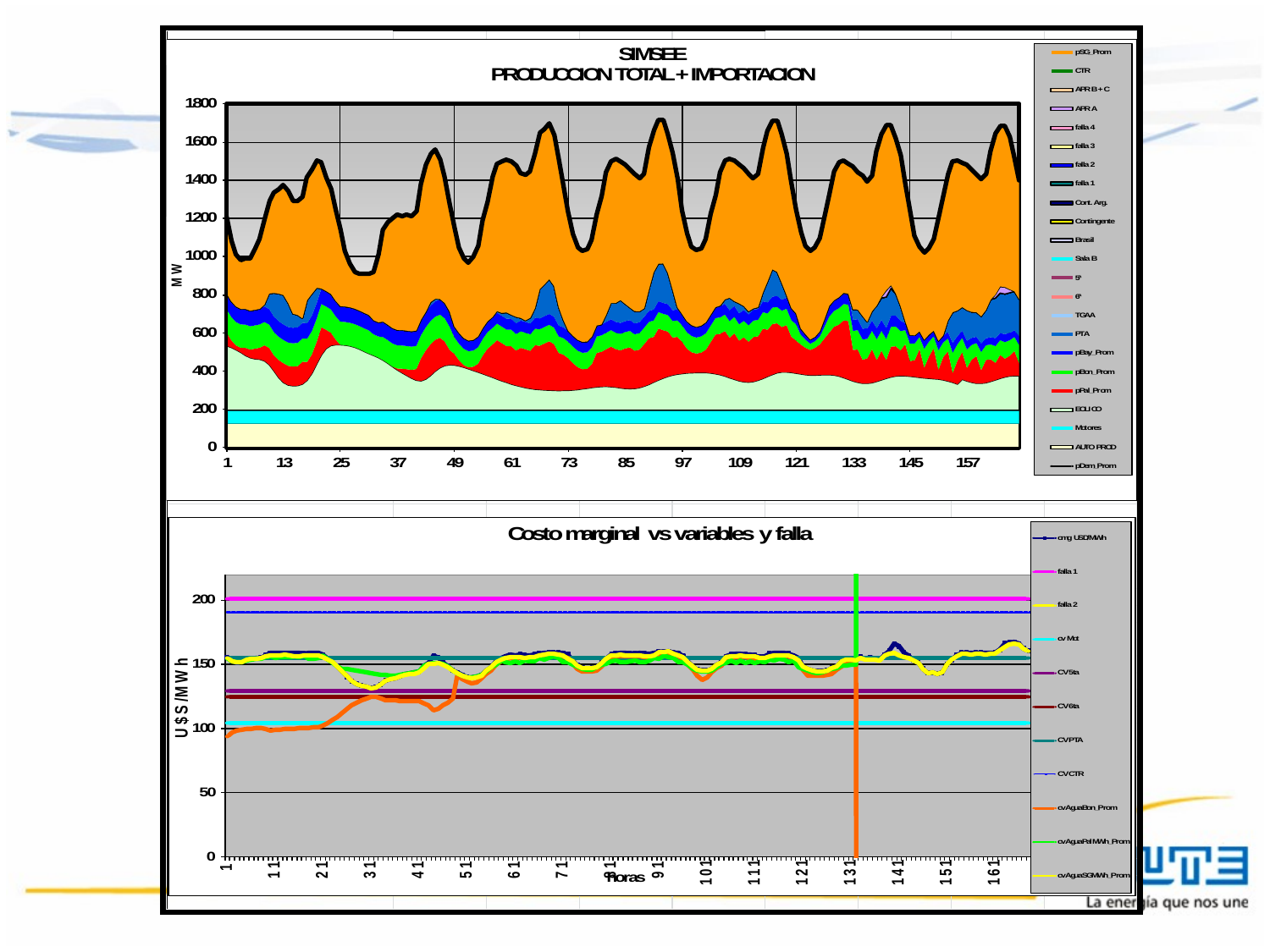
In the bottom chart 'Costo marginal vs variables y falla', is the horizontal cyan cv Mot line greater or less than 150? less In the top chart 'SIMSEE PRODUCCION TOTAL + IMPORTACION', is the lowest point of the black pDem_Prom line greater or less than 800? greater In the bottom chart 'Costo marginal vs variables y falla', what is the first entry listed in the legend? cmg USD/MWh In the top chart 'SIMSEE PRODUCCION TOTAL + IMPORTACION', is the highest peak of the black pDem_Prom line greater or less than 1600? greater What kind of chart is the top chart titled 'SIMSEE PRODUCCION TOTAL + IMPORTACION'? area chart In the bottom chart 'Costo marginal vs variables y falla', which is higher: the magenta falla 1 line or the cyan cv Mot line? falla 1 What kind of chart is the bottom chart titled 'Costo marginal vs variables y falla'? line chart In the top chart 'SIMSEE PRODUCCION TOTAL + IMPORTACION', what is the label on the vertical axis? MW In the bottom chart 'Costo marginal vs variables y falla', does the orange cvAguaBon_Prom line rise or fall between hour 1 and hour 51? rise